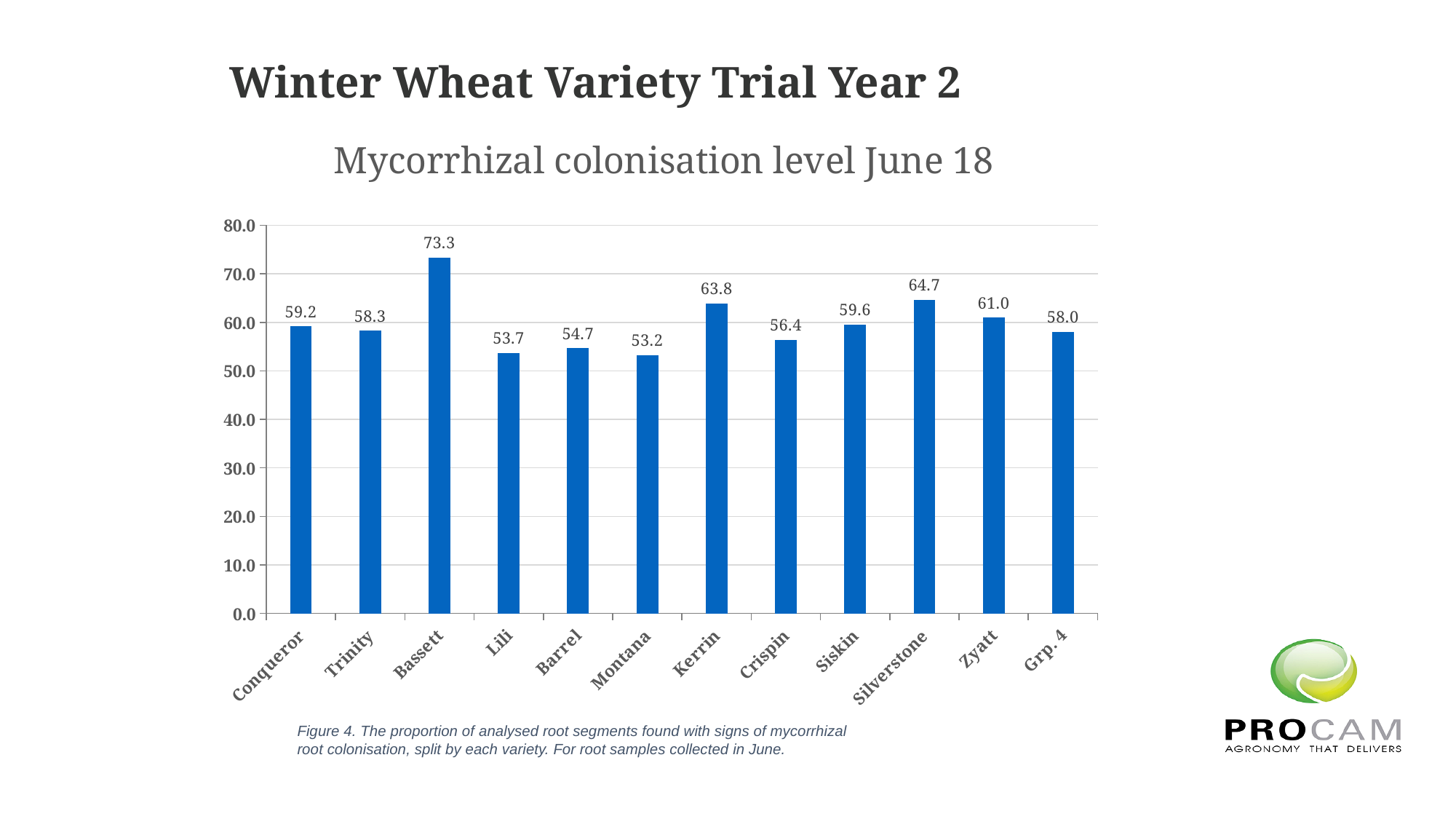
What is the difference between the values for Bassett and Montana? 20.1 What is the mycorrhizal colonisation level for Bassett? 73.3 Which variety has the highest mycorrhizal colonisation level? Bassett What kind of chart is shown on the slide? bar chart What is the value shown for Kerrin? 63.8 Is the value for Lili greater or less than 60.0? less What is the title of the chart? Mycorrhizal colonisation level June 18 What is the value shown for Grp. 4? 58.0 What is the difference between the values for Silverstone and Zyatt? 3.7 Which variety has the lowest mycorrhizal colonisation level? Montana Which has a higher value, Kerrin or Crispin? Kerrin How many varieties are shown on the chart? 12